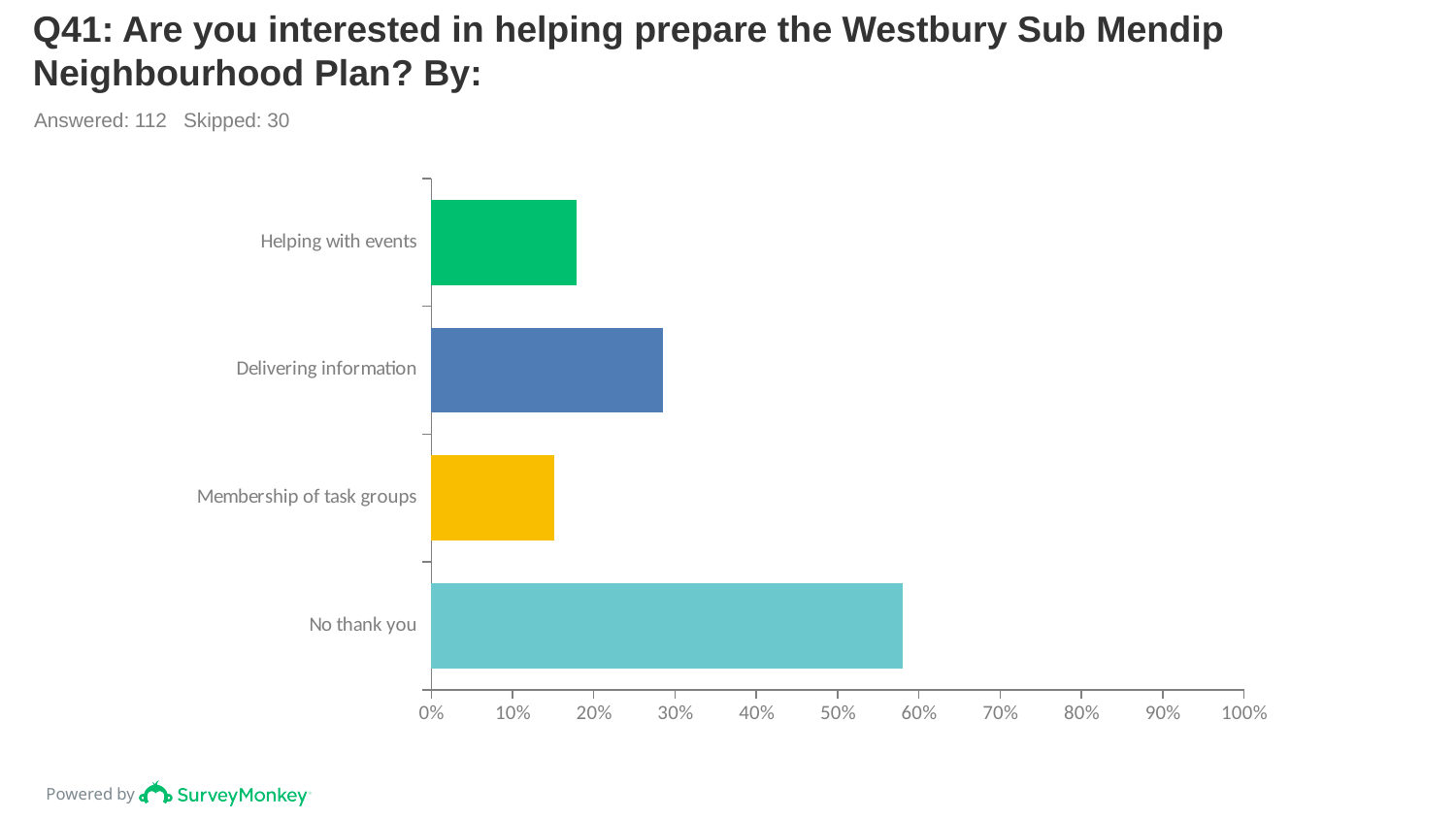
Which category has the highest value? No thank you How many respondents answered this question, according to the slide? 112 How many categories are plotted in the chart? 4 Is the value for Helping with events greater or less than 10%? greater Is the value for Delivering information greater or less than 20%? greater How many respondents skipped this question, according to the slide? 30 Is the value for Membership of task groups greater or less than 20%? less Which is larger, the value for No thank you or the value for Delivering information? No thank you Which category has the lowest value? Membership of task groups Which is larger, the value for Delivering information or the value for Helping with events? Delivering information What kind of chart is shown on the slide? bar chart